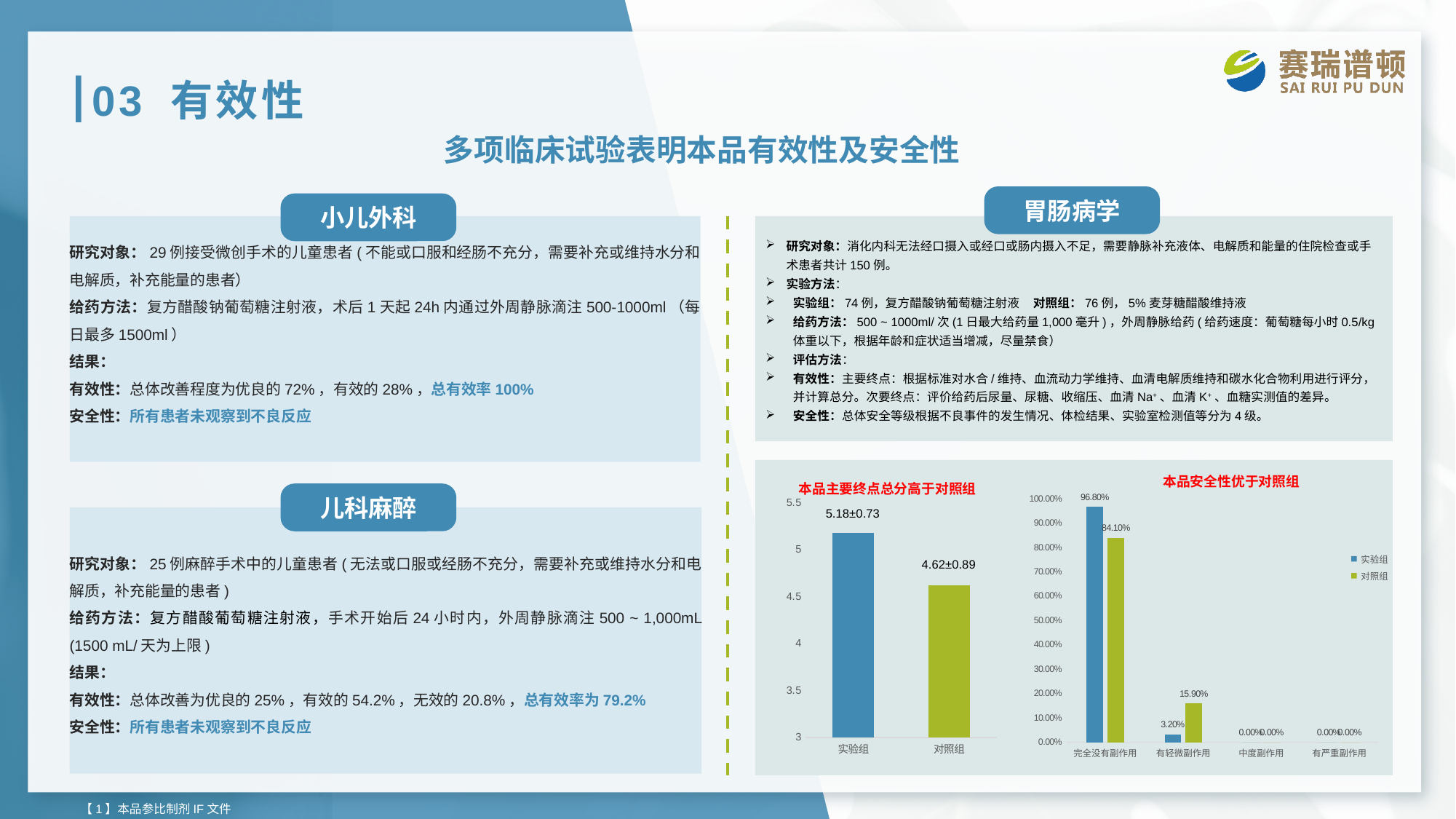
In the chart titled 本品安全性优于对照组, what is the value for 对照组 in the 有轻微副作用 category? 15.90% In the chart titled 本品安全性优于对照组, what is the difference between 实验组 and 对照组 in the 完全没有副作用 category? 12.70% In the chart titled 本品安全性优于对照组, how many categories are shown on the x axis? 4 In the chart titled 本品主要终点总分高于对照组, what is the value for 实验组? 5.18±0.73 In the chart titled 本品主要终点总分高于对照组, which group has the higher bar? 实验组 In the chart titled 本品安全性优于对照组, what is the value for 实验组 in the 完全没有副作用 category? 96.80% In the chart titled 本品安全性优于对照组, how many series does the legend list? 2 In the chart titled 本品主要终点总分高于对照组, is the value for 对照组 greater or less than 5? less What type of chart is the chart titled 本品安全性优于对照组? bar chart In the chart titled 本品主要终点总分高于对照组, what is the value for 对照组? 4.62±0.89 In the chart titled 本品主要终点总分高于对照组, how many bars are plotted? 2 In the chart titled 本品安全性优于对照组, which category has the highest value for 对照组? 完全没有副作用